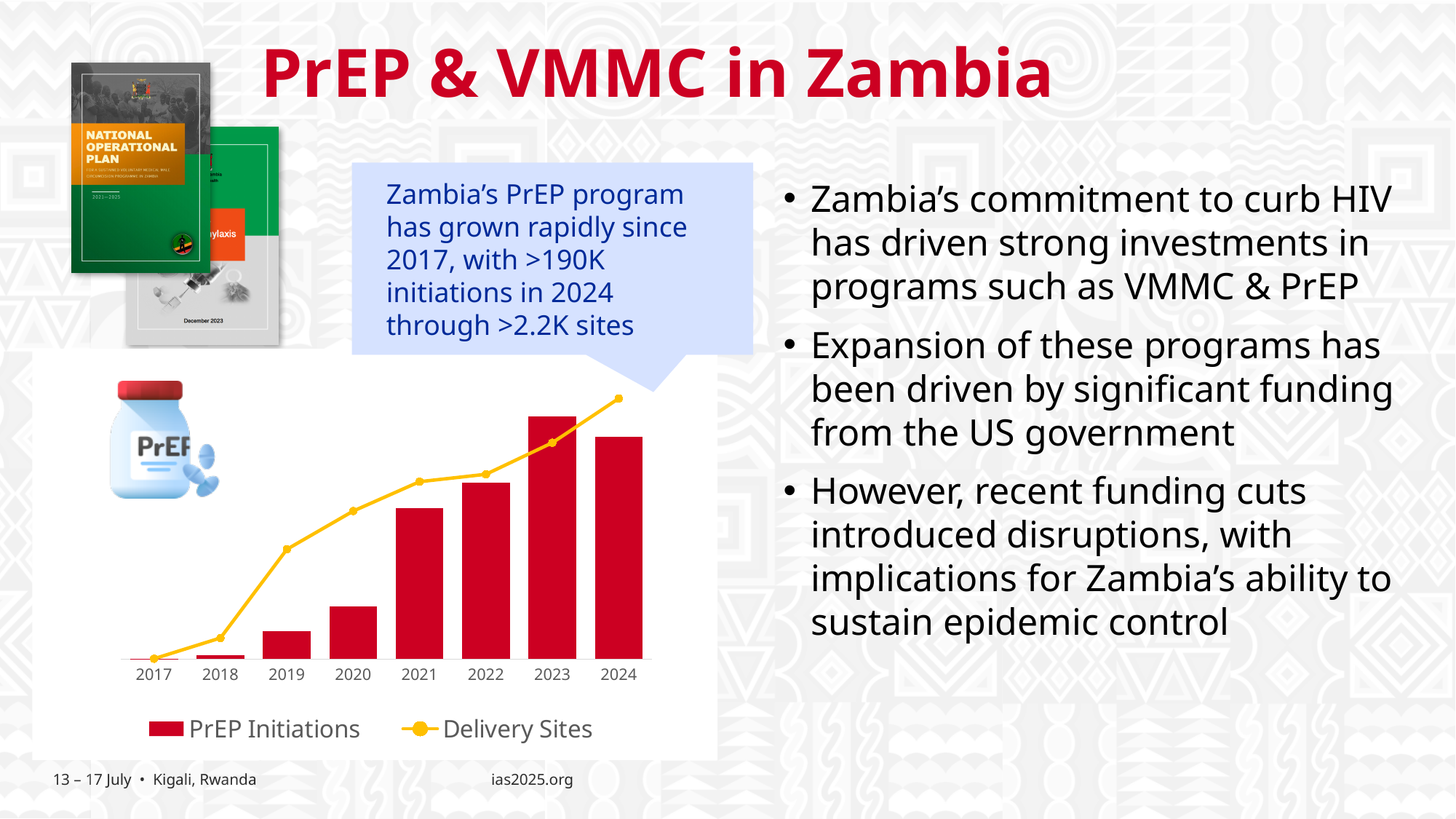
Which series is plotted as a line with markers? Delivery Sites Which year has the highest Delivery Sites value? 2024 What kind of chart is shown on the slide? Combined bar and line chart How many years are shown on the x axis of the chart? 8 Is the PrEP Initiations bar taller in 2020 or in 2021? 2021 Do the Delivery Sites values rise or fall from 2017 to 2024? Rise Which year has the tallest PrEP Initiations bar? 2023 Which year has the lowest PrEP Initiations bar? 2017 Which year has the lowest Delivery Sites value? 2017 What colour are the PrEP Initiations bars? Red Is the PrEP Initiations bar taller in 2023 or in 2024? 2023 How many series does the chart legend list? 2